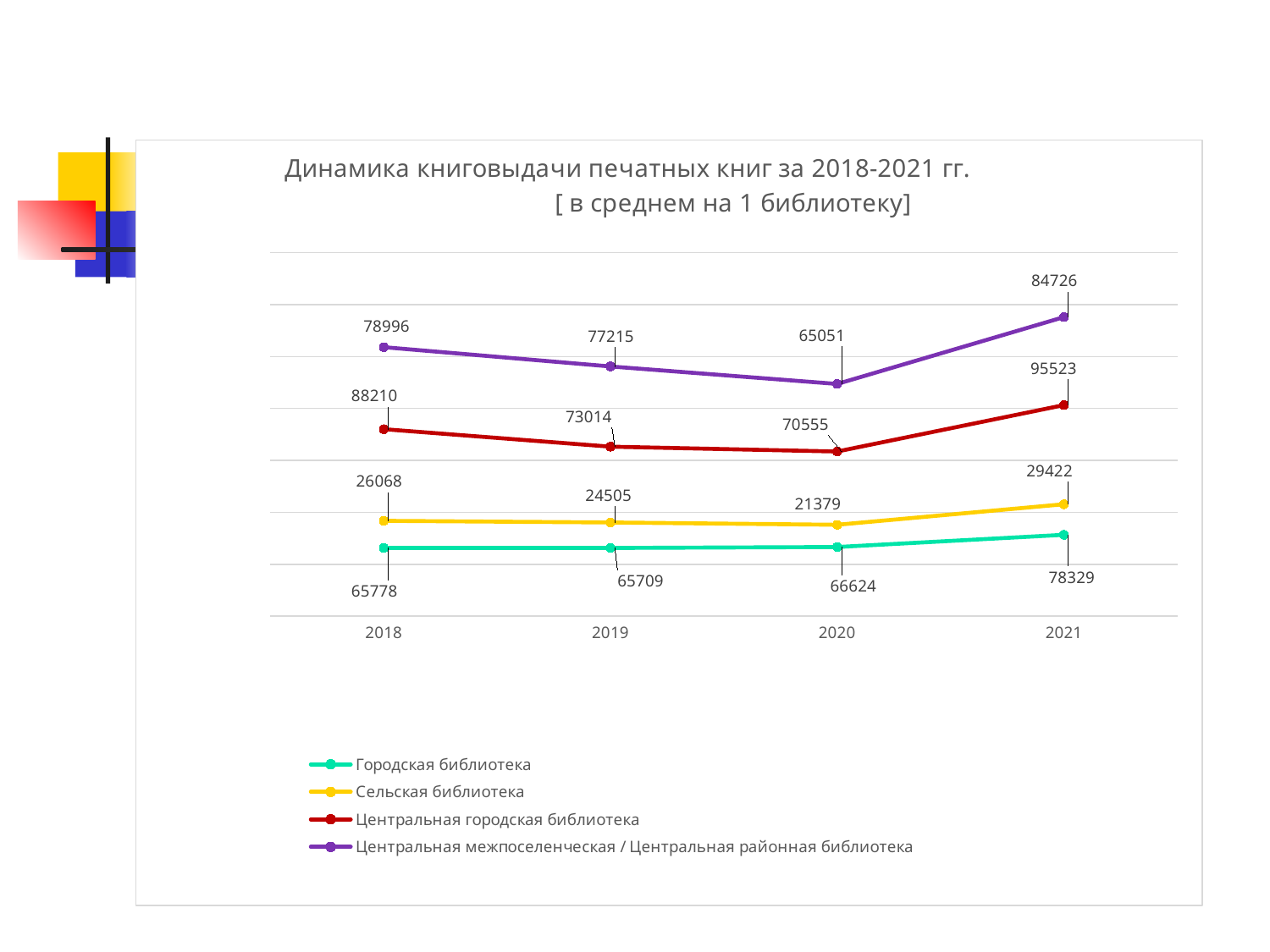
What is the difference between the 2021 and 2020 values for Сельская библиотека? 8043 What is the value for Центральная межпоселенческая / Центральная районная библиотека in 2018? 78996 What kind of chart is shown on the slide? Line chart What is the value for Городская библиотека in 2020? 66624 Which series has the larger value in 2018: Городская библиотека or Сельская библиотека? Городская библиотека How many series does the legend list? 4 What is the value for Сельская библиотека in 2019? 24505 How many years are shown on the x axis? 4 What is the difference between the 2021 and 2020 values for Центральная городская библиотека? 24968 In which year is the value for Сельская библиотека the highest? 2021 In which year is the value for Центральная межпоселенческая / Центральная районная библиотека the lowest? 2020 What is the value for Центральная городская библиотека in 2021? 95523